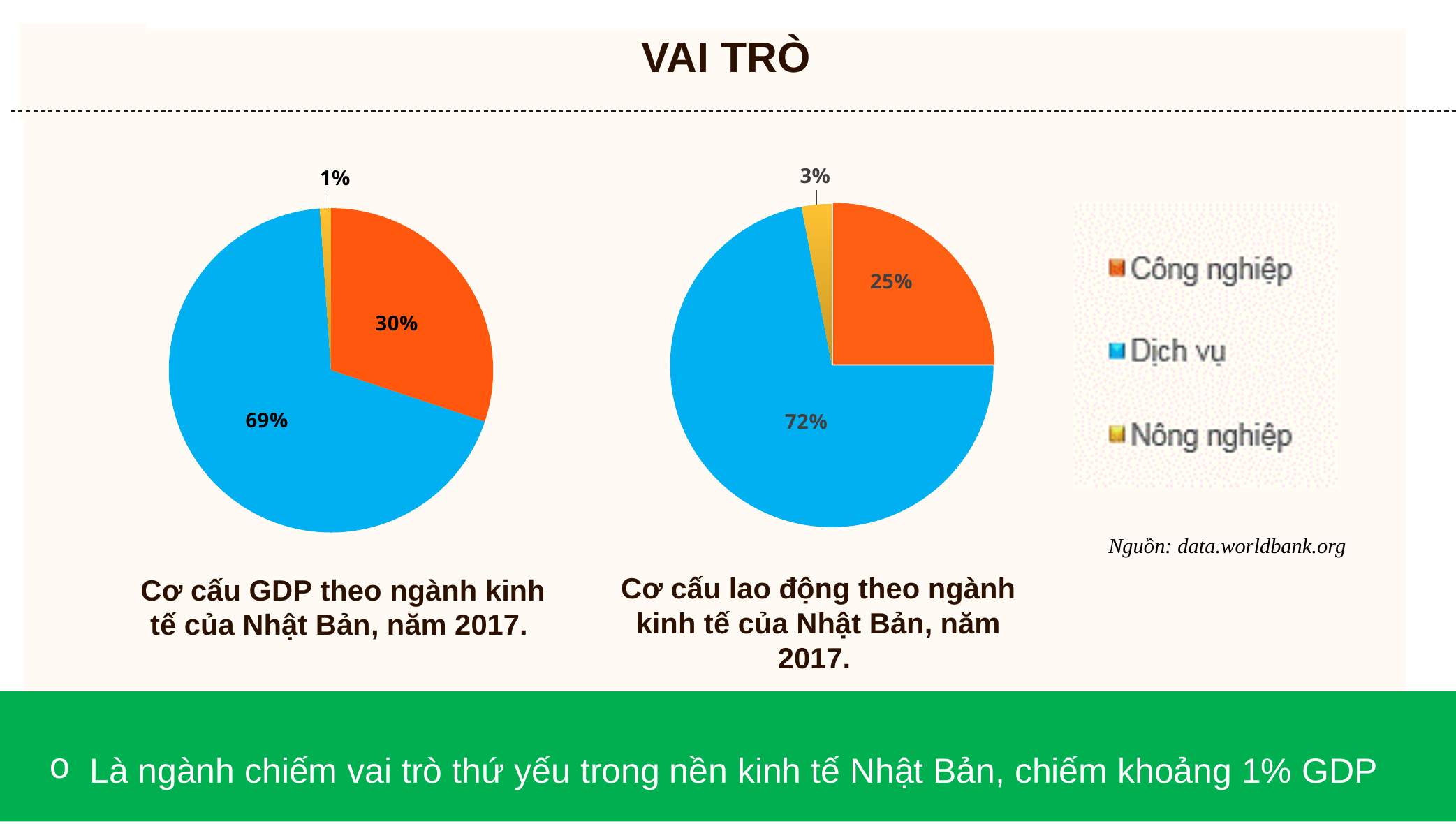
How many slices does the right pie chart (Cơ cấu lao động theo ngành kinh tế của Nhật Bản, năm 2017) have? 3 In the left pie chart (Cơ cấu GDP theo ngành kinh tế của Nhật Bản, năm 2017), which sector has the smallest share? Nông nghiệp Which is larger: the Công nghiệp share in the left pie chart (GDP) or the Công nghiệp share in the right pie chart (lao động)? The left pie chart (GDP), 30% What type of chart is used for Cơ cấu GDP theo ngành kinh tế của Nhật Bản, năm 2017? Pie chart In the right pie chart (Cơ cấu lao động theo ngành kinh tế của Nhật Bản, năm 2017), which sector has the largest share? Dịch vụ In the left pie chart (Cơ cấu GDP theo ngành kinh tế của Nhật Bản, năm 2017), what is the difference between the Dịch vụ share and the Công nghiệp share? 39% In the right pie chart (Cơ cấu lao động theo ngành kinh tế của Nhật Bản, năm 2017), what share does Nông nghiệp have? 3% In the right pie chart (Cơ cấu lao động theo ngành kinh tế của Nhật Bản, năm 2017), what share does Dịch vụ have? 72% In the left pie chart (Cơ cấu GDP theo ngành kinh tế của Nhật Bản, năm 2017), what share does Dịch vụ have? 69% What colour represents Dịch vụ in the legend? Blue In the left pie chart (Cơ cấu GDP theo ngành kinh tế của Nhật Bản, năm 2017), what share does Nông nghiệp have? 1% In the left pie chart (Cơ cấu GDP theo ngành kinh tế của Nhật Bản, năm 2017), what share does Công nghiệp have? 30%